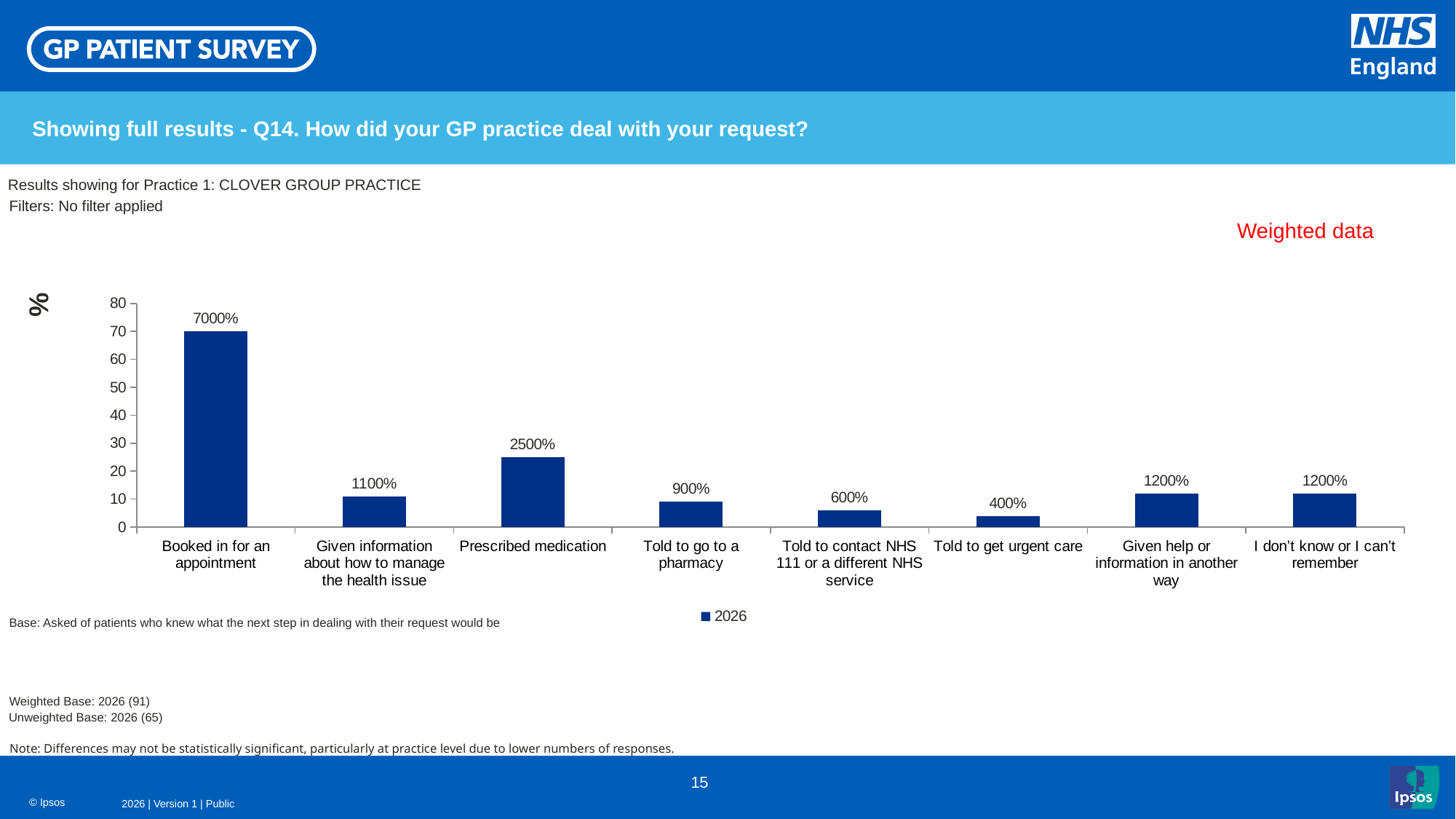
Is the bar for 'Booked in for an appointment' above or below the 60 mark on the axis? above What is the data label shown for 'Told to contact NHS 111 or a different NHS service'? 600% How many categories are shown on the x axis? 8 What is the data label shown for 'Booked in for an appointment'? 7000% Which category has the highest bar? Booked in for an appointment What is the data label shown for 'Told to get urgent care'? 400% How many series does the legend list? 1 Which category has the lowest bar? Told to get urgent care Which bar is taller: 'Prescribed medication' or 'Told to go to a pharmacy'? Prescribed medication What is the data label shown for 'Prescribed medication'? 2500% What type of chart is shown? Bar chart What is the legend entry shown below the chart? 2026